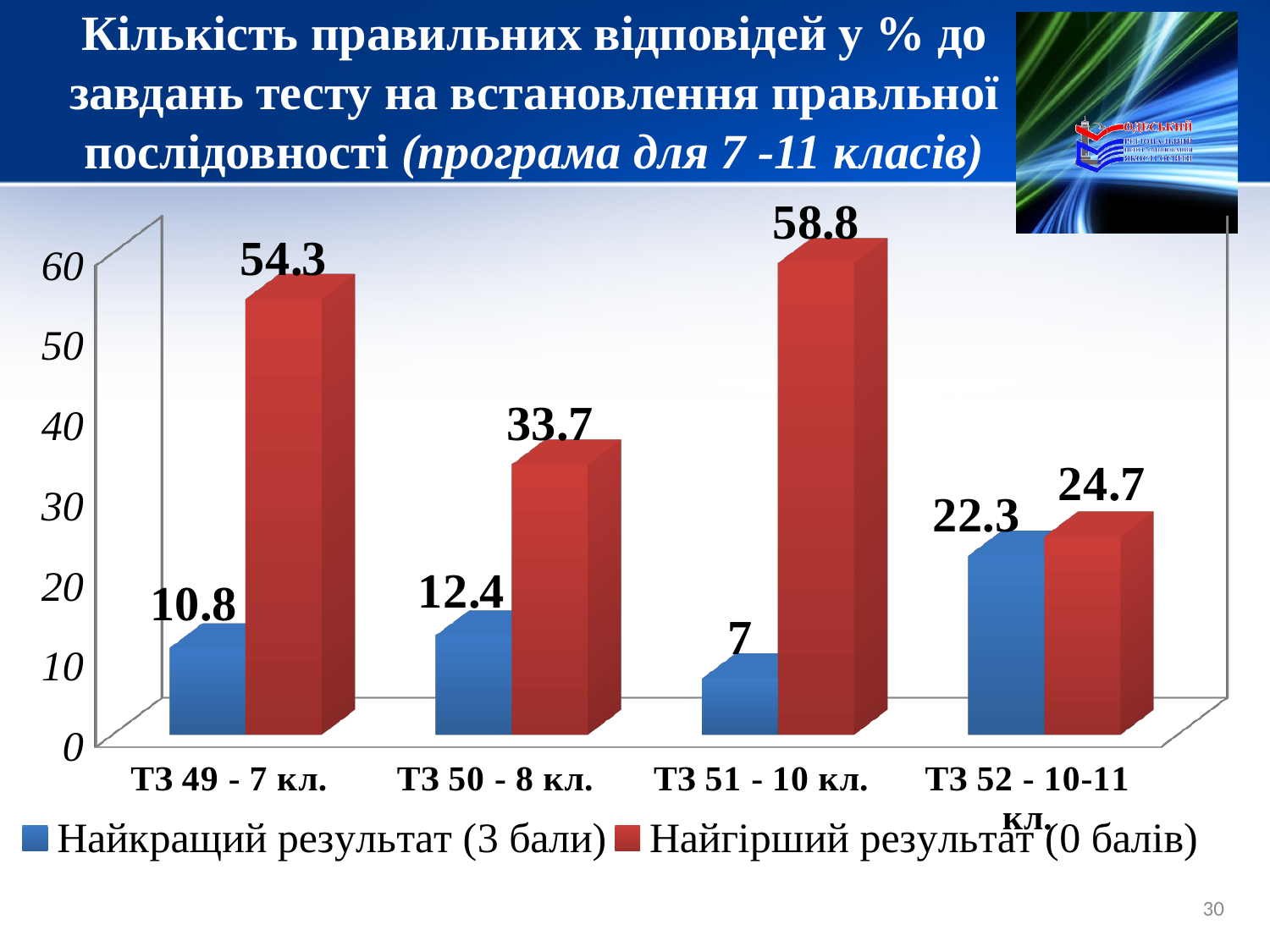
What kind of chart is shown on the slide? bar chart What is the value of 'Найгірший результат (0 балів)' for ТЗ 50 - 8 кл.? 33.7 Which category has the highest value for 'Найгірший результат (0 балів)'? ТЗ 51 - 10 кл. What is the value of 'Найкращий результат (3 бали)' for ТЗ 49 - 7 кл.? 10.8 How many categories are shown on the x axis? 4 What is the value of 'Найгірший результат (0 балів)' for ТЗ 51 - 10 кл.? 58.8 How many series does the legend list? 2 Which category has the lowest value for 'Найкращий результат (3 бали)'? ТЗ 51 - 10 кл. Which colour represents 'Найкращий результат (3 бали)' in the chart? blue What is the difference between 'Найгірший результат (0 балів)' and 'Найкращий результат (3 бали)' for ТЗ 49 - 7 кл.? 43.5 Is the value of 'Найгірший результат (0 балів)' for ТЗ 49 - 7 кл. greater or less than 50? greater Which is larger for ТЗ 52 - 10-11 кл.: 'Найкращий результат (3 бали)' or 'Найгірший результат (0 балів)'? Найгірший результат (0 балів)